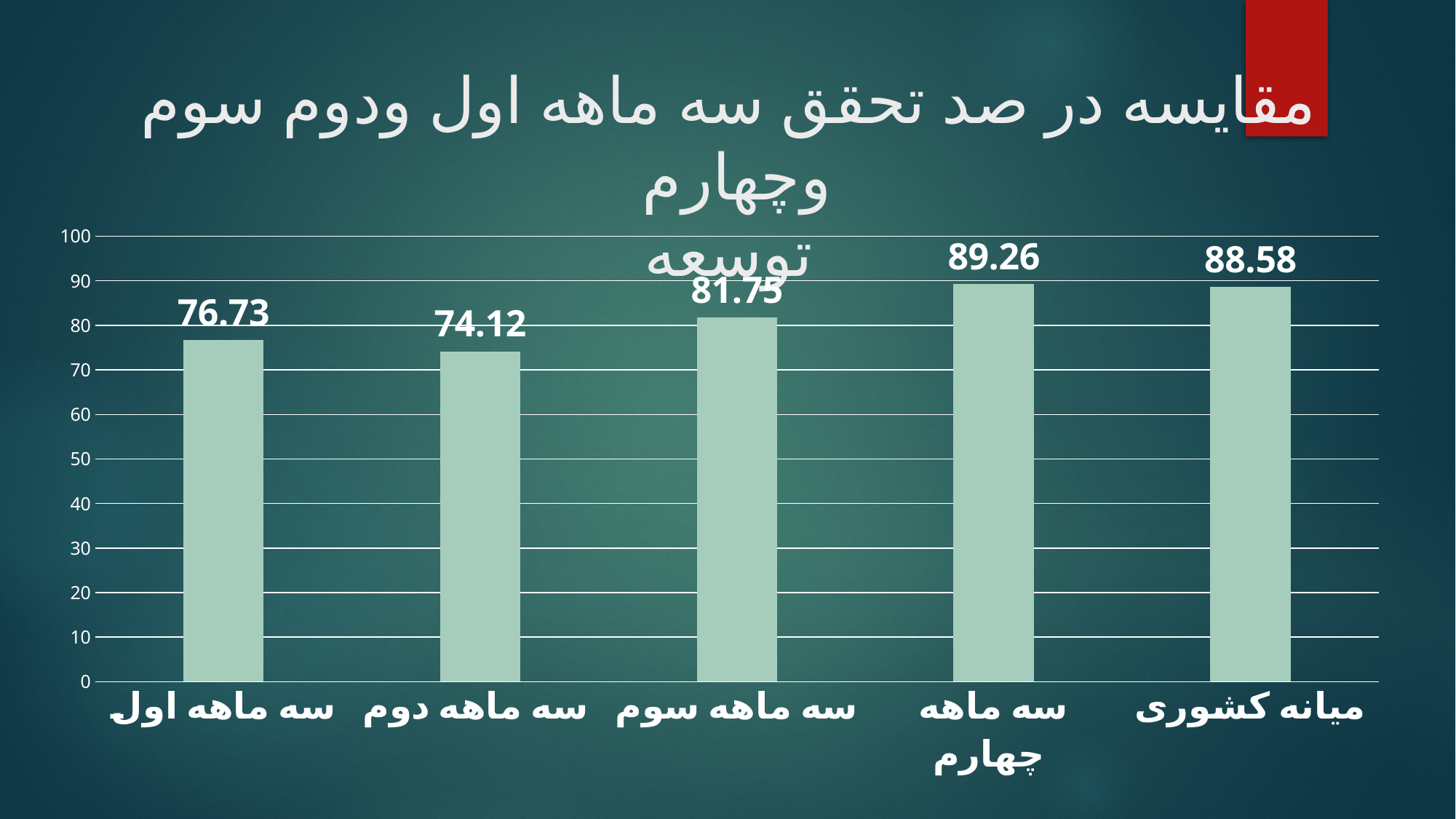
What is the value for میانه کشوری (national median)? 88.58 What is the value for سه ماهه دوم (second quarter)? 74.12 Is the value for سه ماهه چهارم greater or less than 80? greater Which is larger, the value for سه ماهه سوم or the value for سه ماهه دوم? سه ماهه سوم Which category has the lowest value? سه ماهه دوم What kind of chart is shown on the slide? bar chart Which category has the highest value? سه ماهه چهارم What is the difference between the values for سه ماهه چهارم and سه ماهه اول? 12.53 What is the value for سه ماهه اول (first quarter)? 76.73 What is the maximum value shown on the vertical axis? 100 What is the value for سه ماهه سوم (third quarter)? 81.75 How many categories are shown on the x axis? 5